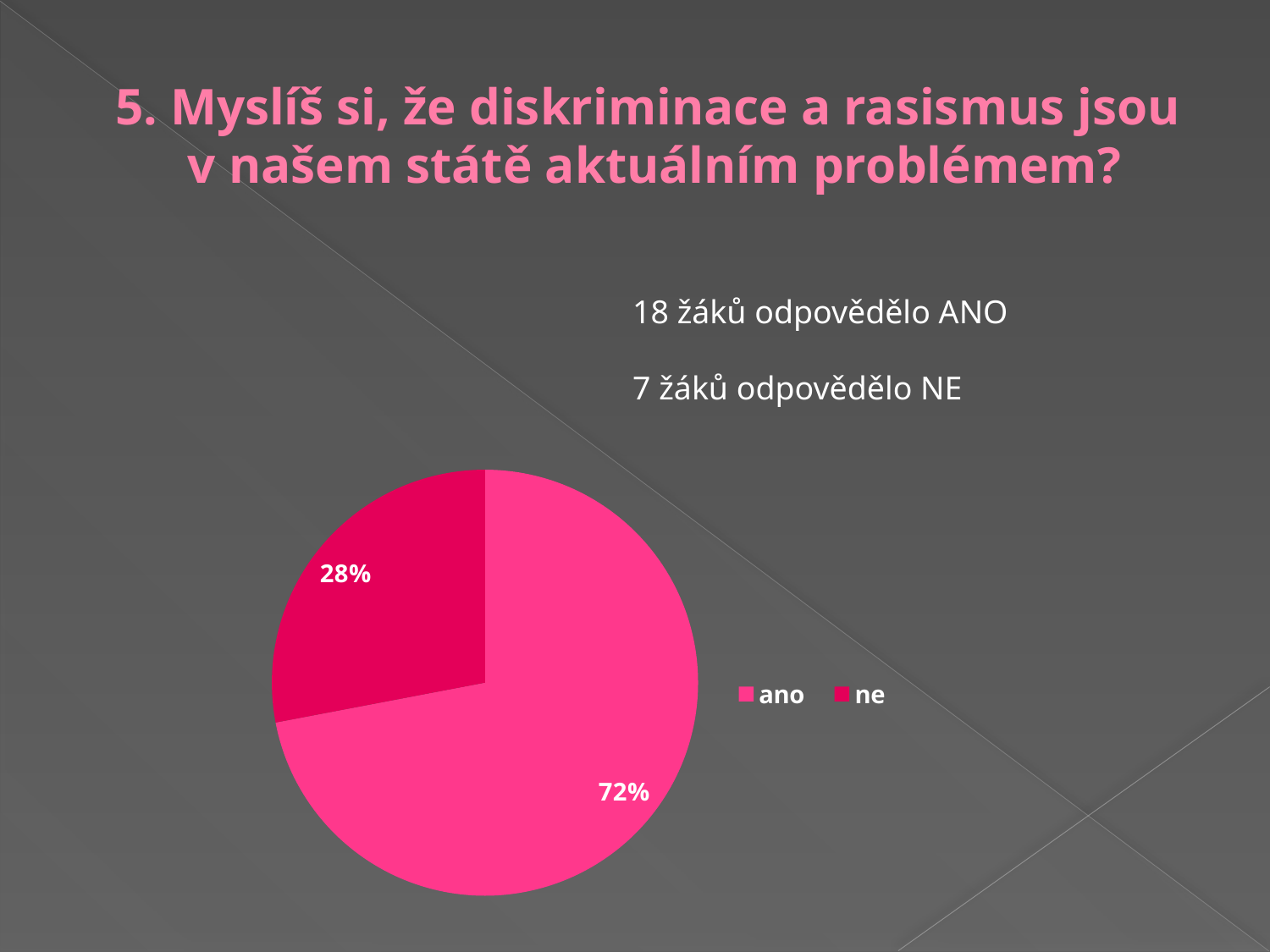
Which is larger, the "ano" slice or the "ne" slice? ano What share of the pie does the "ne" slice represent? 28% What are the two legend entries of the pie chart? ano, ne How many entries does the legend list? 2 What is the difference in percentage points between the "ano" and "ne" slices? 44 Where is the legend positioned relative to the pie? to the right Which slice of the pie is the smallest? ne What kind of chart is shown on the slide? pie chart Which slice of the pie is the largest? ano How many slices does the pie chart have? 2 What share of the pie does the "ano" slice represent? 72% Is the share of the "ne" slice greater or less than 50%? less